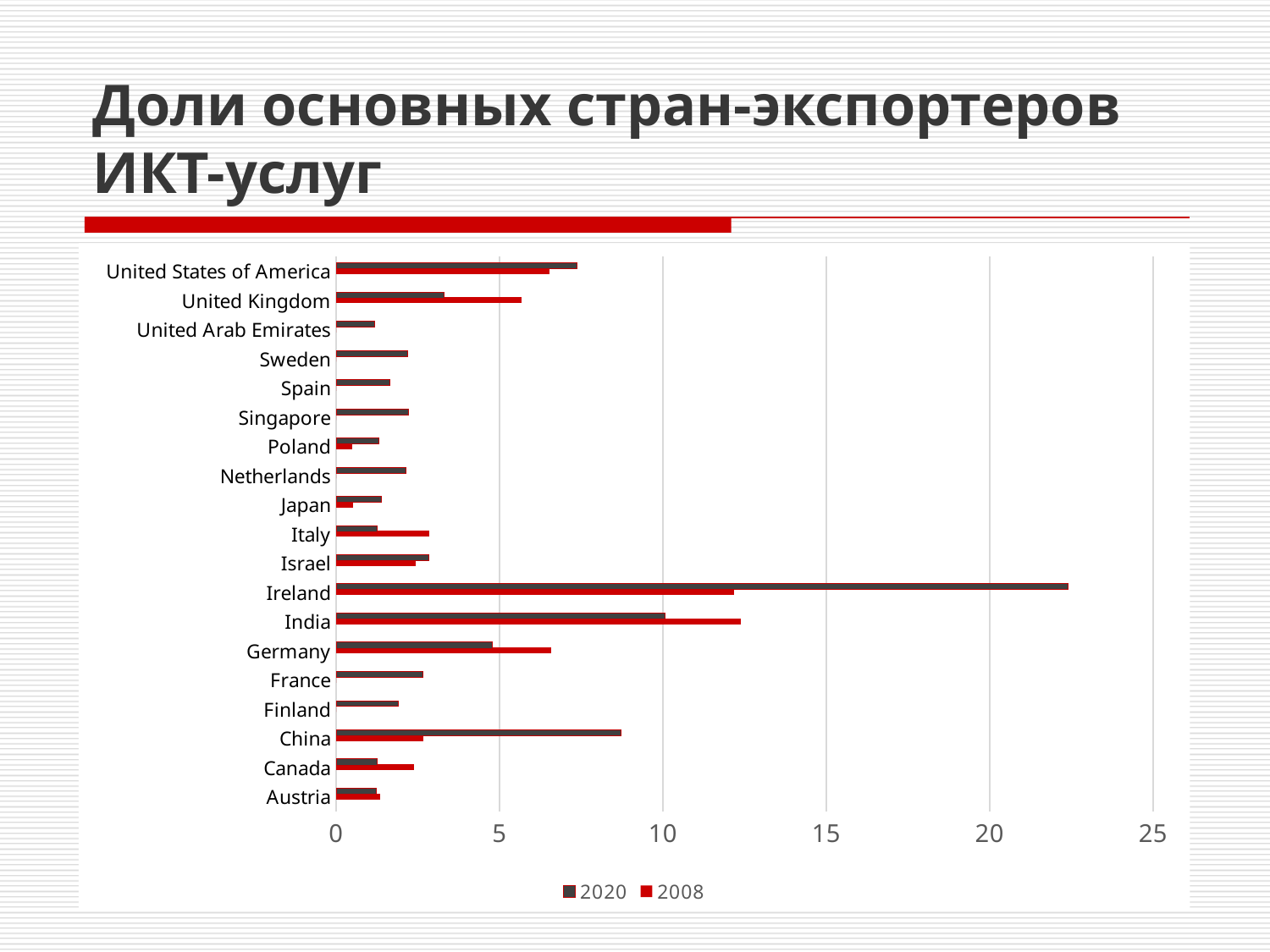
How many countries are shown on the chart? 19 For Ireland, which series has the larger value, 2020 or 2008? 2020 Is the 2020 value for United Kingdom greater or less than 5? less For China, which series has the larger value, 2020 or 2008? 2020 Which country has the highest value for 2020? Ireland Is the 2020 value for Ireland greater or less than 20? greater Which country has the highest value for 2008? India Which colour represents the 2008 series in the legend? red Is the 2008 value for China greater or less than 5? less What kind of chart is shown on the slide? bar chart How many series does the legend list? 2